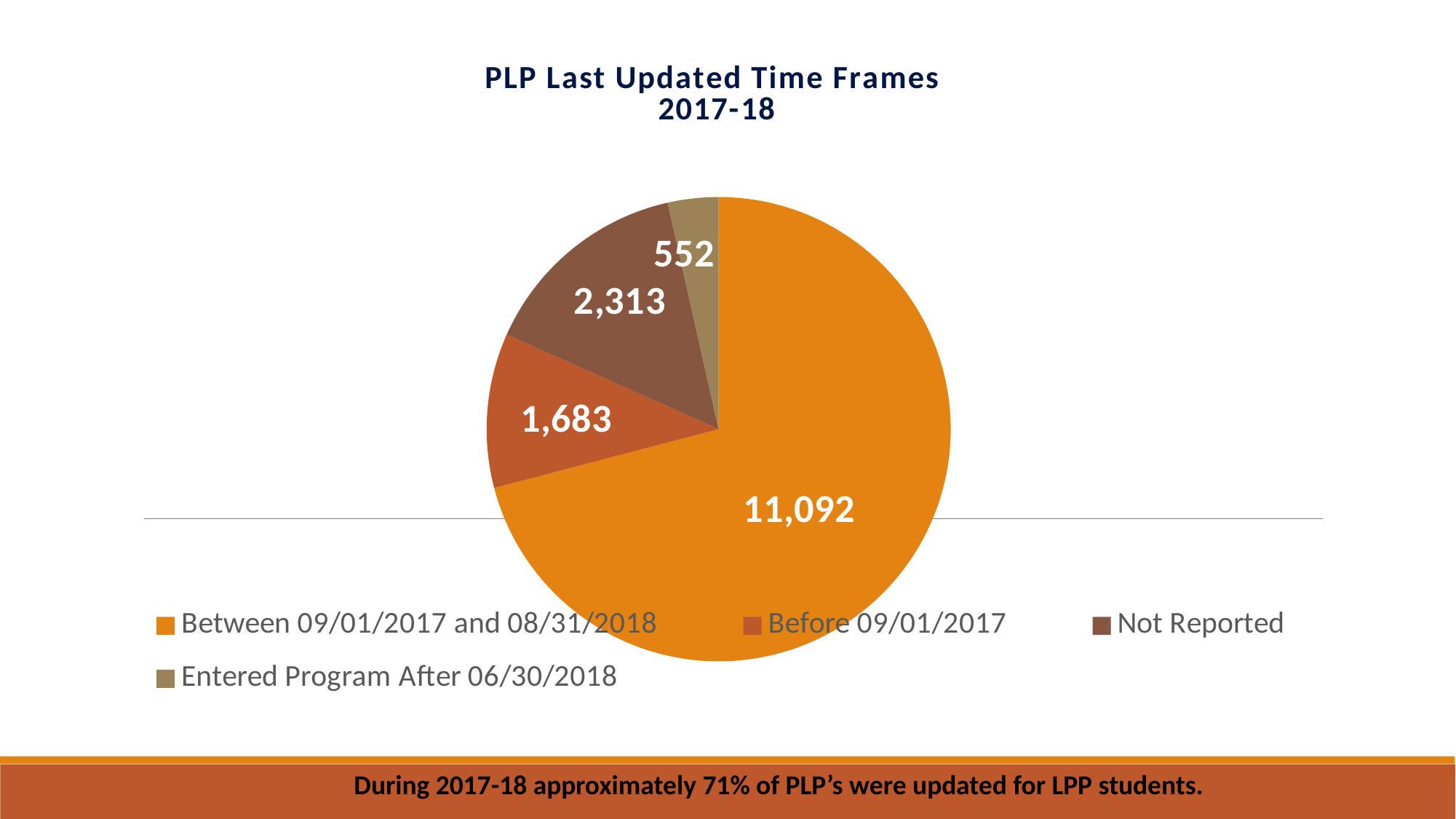
How many slices does the pie chart have? 4 Which is larger, the 'Not Reported' slice or the 'Before 09/01/2017' slice? Not Reported Which category has the largest slice of the pie? Between 09/01/2017 and 08/31/2018 What is the difference between the 'Not Reported' value and the 'Before 09/01/2017' value? 630 What is the value for the 'Entered Program After 06/30/2018' slice? 552 Which category has the smallest slice of the pie? Entered Program After 06/30/2018 What is the value for the 'Between 09/01/2017 and 08/31/2018' slice? 11,092 What is the value for the 'Not Reported' slice? 2,313 What is the title of the chart? PLP Last Updated Time Frames 2017-18 What is the value for the 'Before 09/01/2017' slice? 1,683 What kind of chart is shown on the slide? Pie chart What is the difference between the 'Between 09/01/2017 and 08/31/2018' value and the 'Before 09/01/2017' value? 9,409